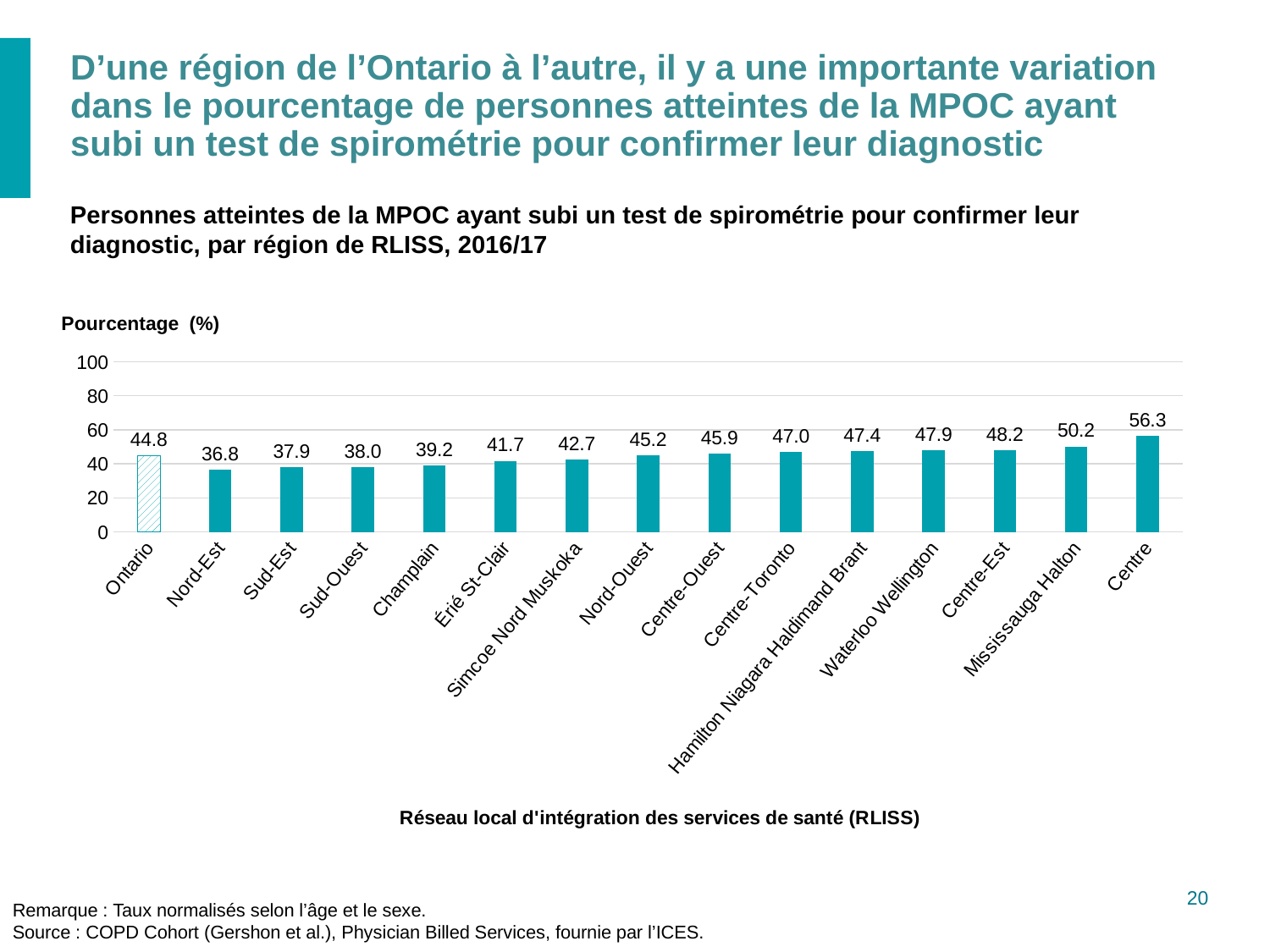
Which region has the highest value? Centre What kind of chart is shown on the slide? Bar chart What is the value for Ontario? 44.8 What is the difference between the values for Centre and Nord-Est? 19.5 Which has a larger value, Champlain or Mississauga Halton? Mississauga Halton Is the value for Centre greater or less than 40? greater How many bars are shown in the chart? 15 What is the value for Centre-Toronto? 47.0 Do the values rise or fall from Nord-Est to Centre along the x axis? Rise What is the label of the x axis? Réseau local d'intégration des services de santé (RLISS) Which region has the lowest value? Nord-Est What is the value for Simcoe Nord Muskoka? 42.7